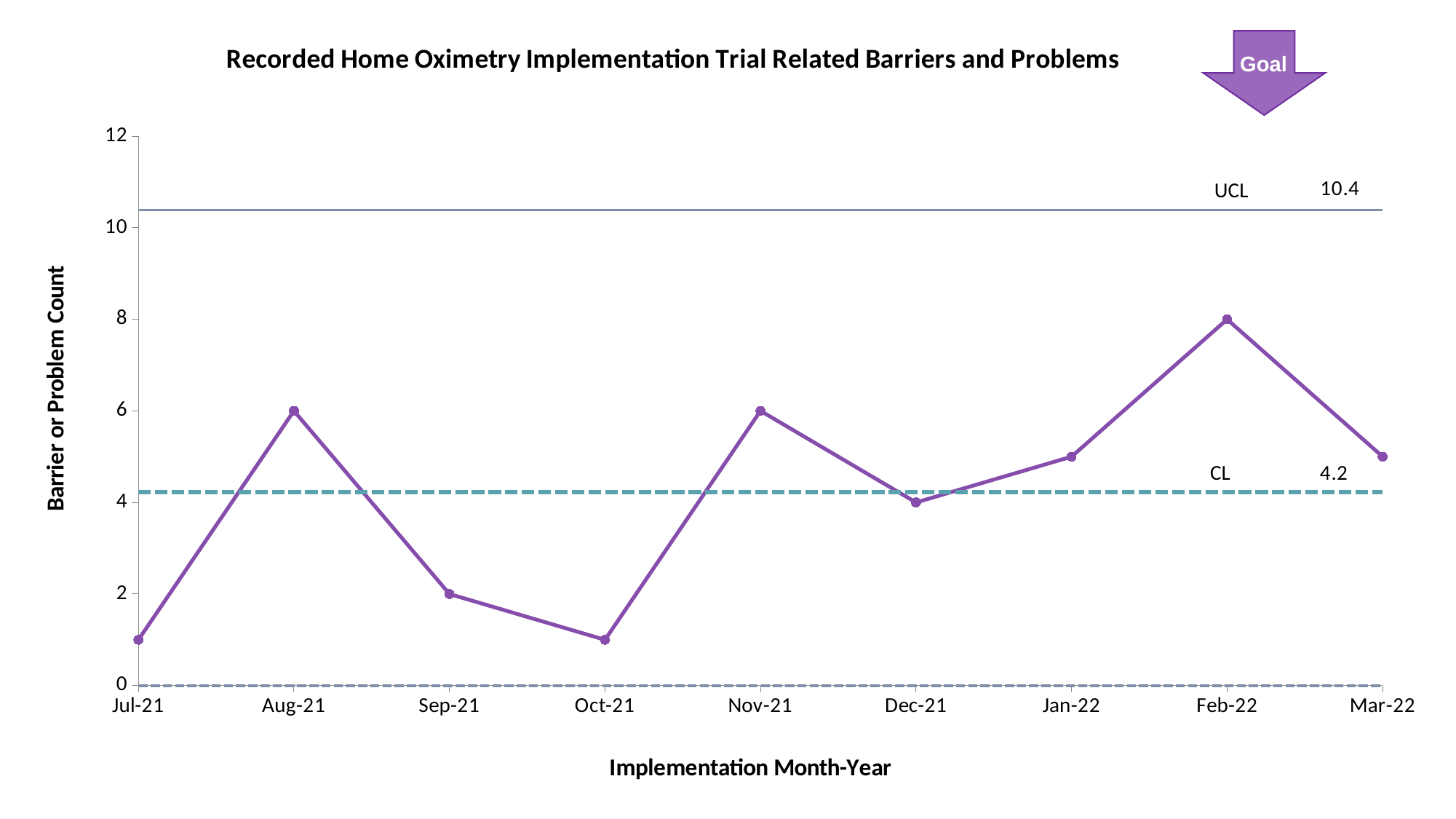
What is the difference between the barrier or problem count for Feb-22 and Sep-21? 6 Is the barrier or problem count for Jul-21 greater or less than 2? less What is the title of the chart? Recorded Home Oximetry Implementation Trial Related Barriers and Problems Which month has a higher barrier or problem count, Aug-21 or Dec-21? Aug-21 What is the value of the UCL line shown on the chart? 10.4 What is the barrier or problem count for Feb-22? 8 What is the barrier or problem count for Dec-21? 4 What type of chart is shown on the slide? line chart How many months are plotted on the x axis? 9 Which month has the highest barrier or problem count? Feb-22 What is the barrier or problem count for Sep-21? 2 Is the barrier or problem count for Mar-22 greater or less than 4? greater